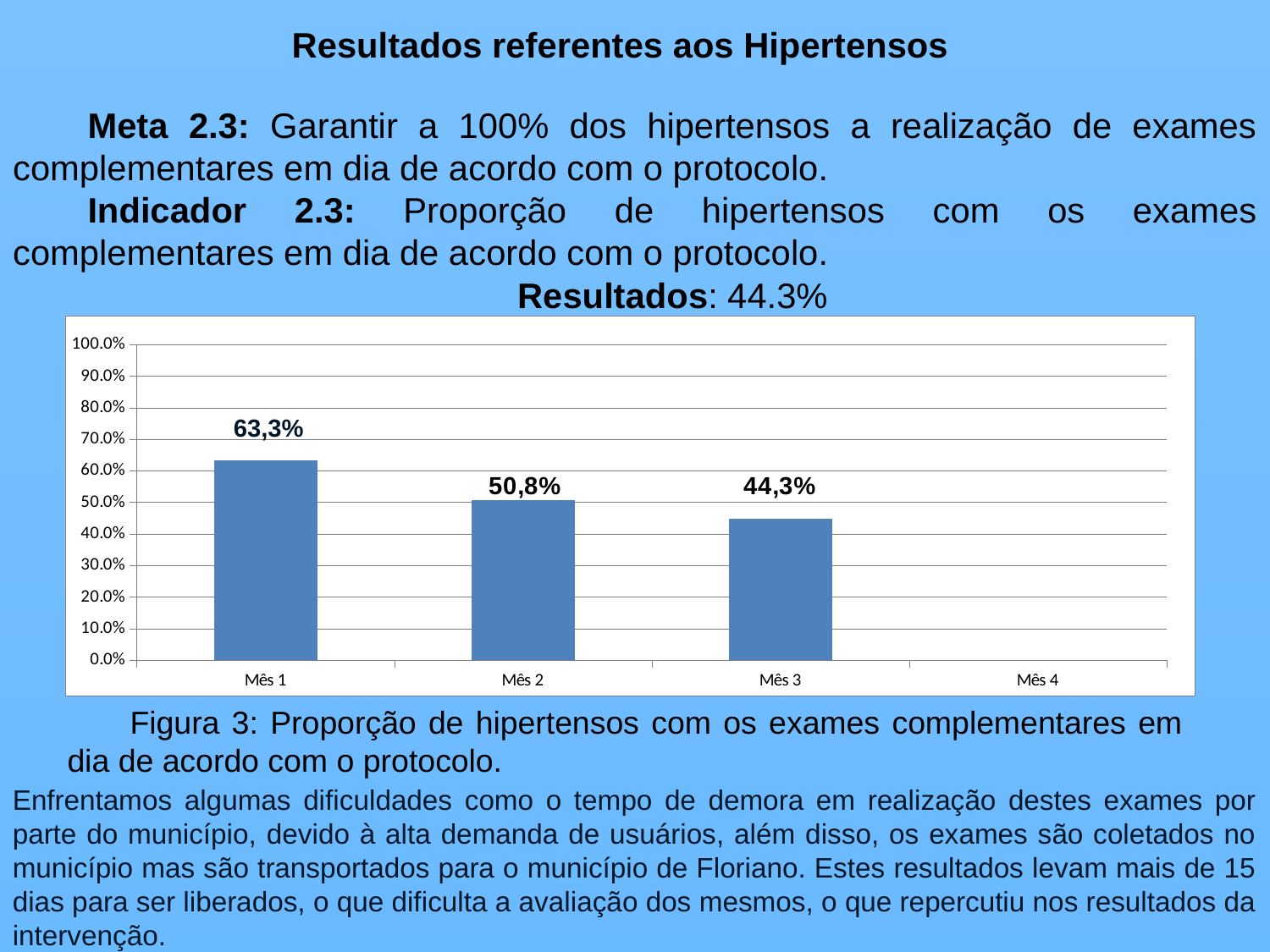
Do the values rise or fall from Mês 1 to Mês 3? Fall What is the value shown for Mês 1? 63,3% Which is larger, the value for Mês 2 or the value for Mês 3? Mês 2 Among the months with a plotted bar, which has the lowest value? Mês 3 What is the difference between the values for Mês 1 and Mês 3? 19,0% What is the difference between the values for Mês 1 and Mês 2? 12,5% What kind of chart is shown on the slide? Bar chart How many month categories are labelled on the x axis? 4 Which month has the highest value in the chart? Mês 1 What is the value shown for Mês 3? 44,3% Is the value for Mês 1 greater or less than 60.0%? greater What is the value shown for Mês 2? 50,8%